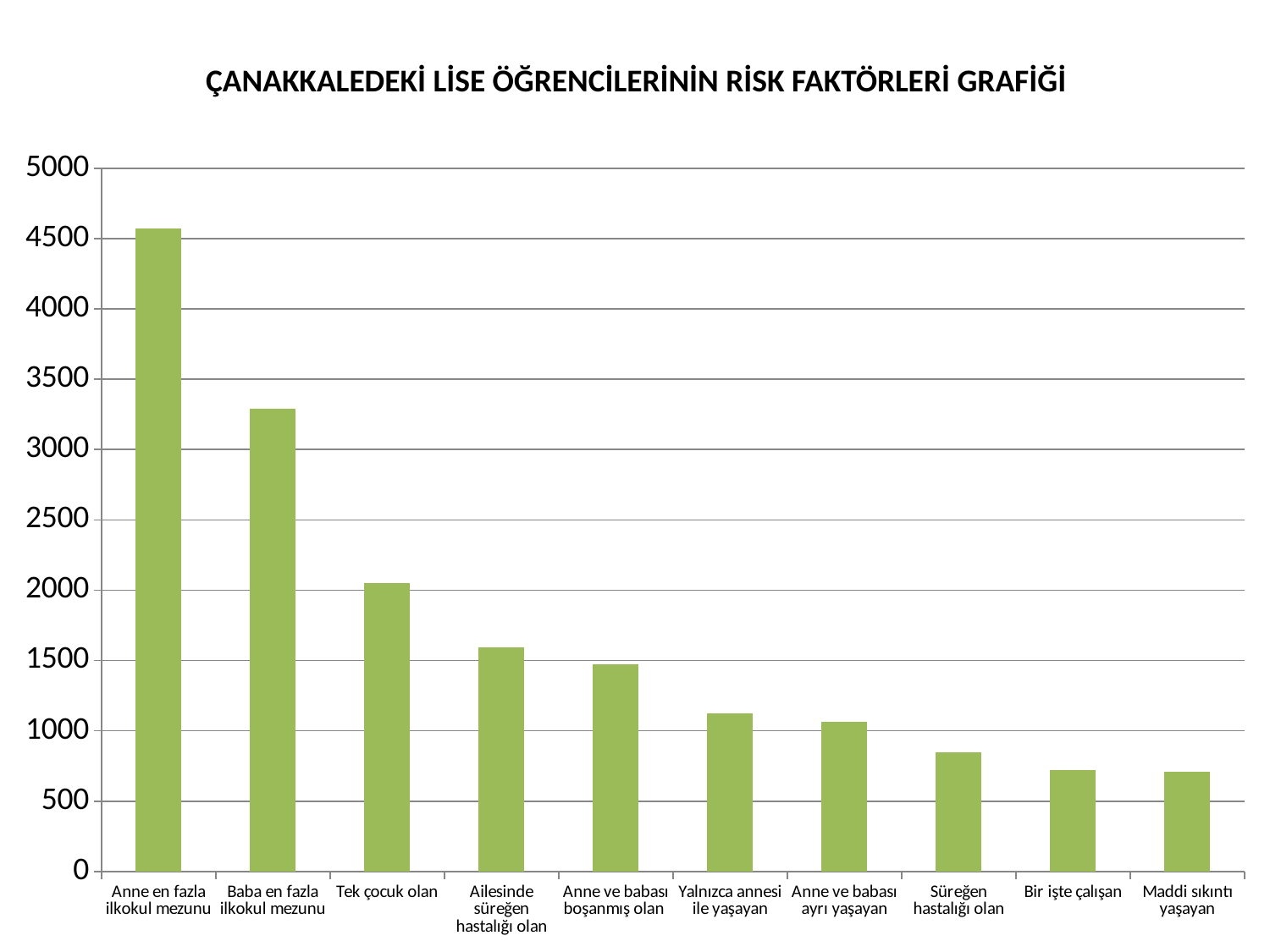
Is the value for Tek çocuk olan greater or less than 2500? less What kind of chart is shown on the slide? bar chart Is the value for Süreğen hastalığı olan greater or less than 1000? less Which is larger, the value for Tek çocuk olan or the value for Ailesinde süreğen hastalığı olan? Tek çocuk olan Is the value for Maddi sıkıntı yaşayan greater or less than 1000? less Which category has the highest value? Anne en fazla ilkokul mezunu What is the title of the chart? ÇANAKKALEDEKİ LİSE ÖĞRENCİLERİNİN RİSK FAKTÖRLERİ GRAFİĞİ Do the values rise or fall from left to right along the x axis? fall How many categories are plotted on the chart? 10 Which is larger, the value for Yalnızca annesi ile yaşayan or the value for Süreğen hastalığı olan? Yalnızca annesi ile yaşayan